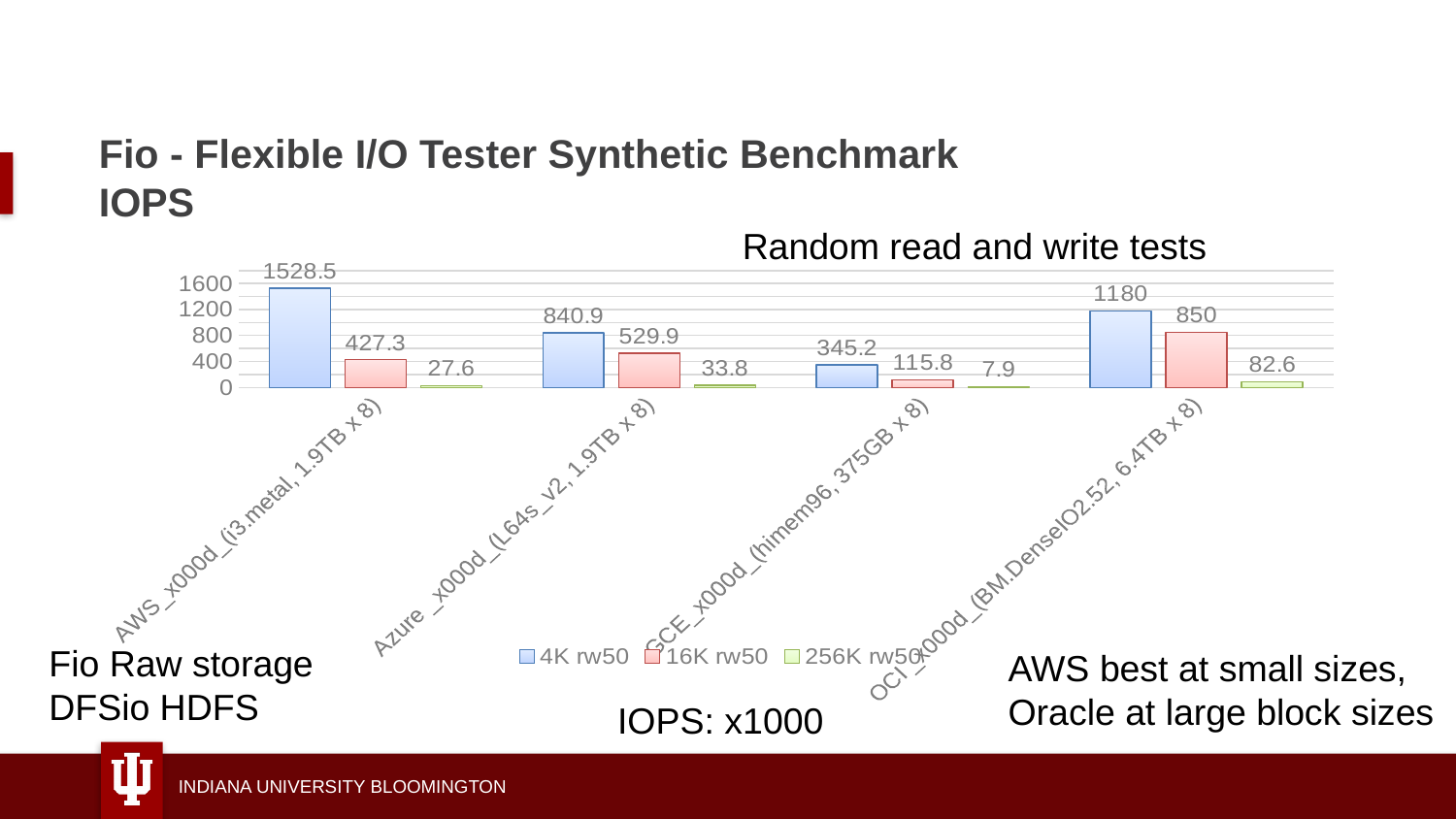
What is the 16K rw50 value for Azure (L64s_v2, 1.9TB x 8)? 529.9 What is the 256K rw50 value for GCE (himem96, 375GB x 8)? 7.9 What is the difference between the 4K rw50 values for AWS and OCI? 348.5 How many series does the legend list? 3 Which is larger: the 16K rw50 value for Azure or the 16K rw50 value for AWS? Azure What is the title of the chart? Random read and write tests What is the 4K rw50 value for AWS (i3.metal, 1.9TB x 8)? 1528.5 Which category has the highest 4K rw50 value? AWS (i3.metal, 1.9TB x 8) Which category has the lowest 256K rw50 value? GCE (himem96, 375GB x 8) What kind of chart is shown on the slide? Bar chart How many categories are shown on the x axis? 4 What is the 16K rw50 value for OCI (BM.DenseIO2.52, 6.4TB x 8)? 850